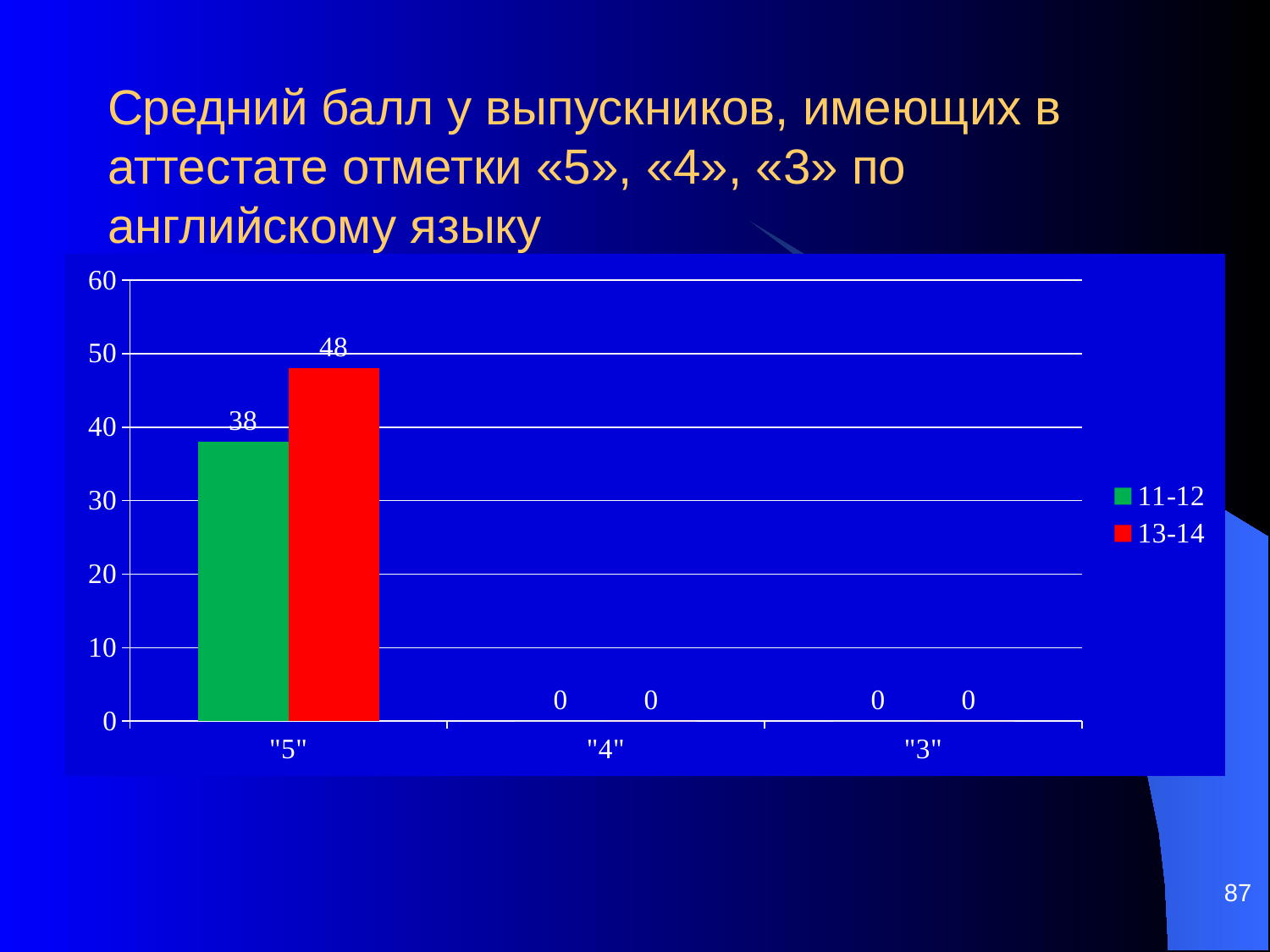
What is the difference between the 13-14 and 11-12 values in the "5" category? 10 In the "5" category, which series has the larger value, 11-12 or 13-14? 13-14 What colour represents the 13-14 series in the legend? red What is the value for the 11-12 series in the "5" category? 38 Is the value for the 11-12 series in the "5" category greater or less than 40? less What is the value for the 11-12 series in the "4" category? 0 How many categories are shown on the x axis? 3 What kind of chart is shown on the slide? bar chart What is the value for the 13-14 series in the "5" category? 48 Which category has the highest value for the 13-14 series? "5" How many series does the legend list? 2 What is the value for the 13-14 series in the "3" category? 0